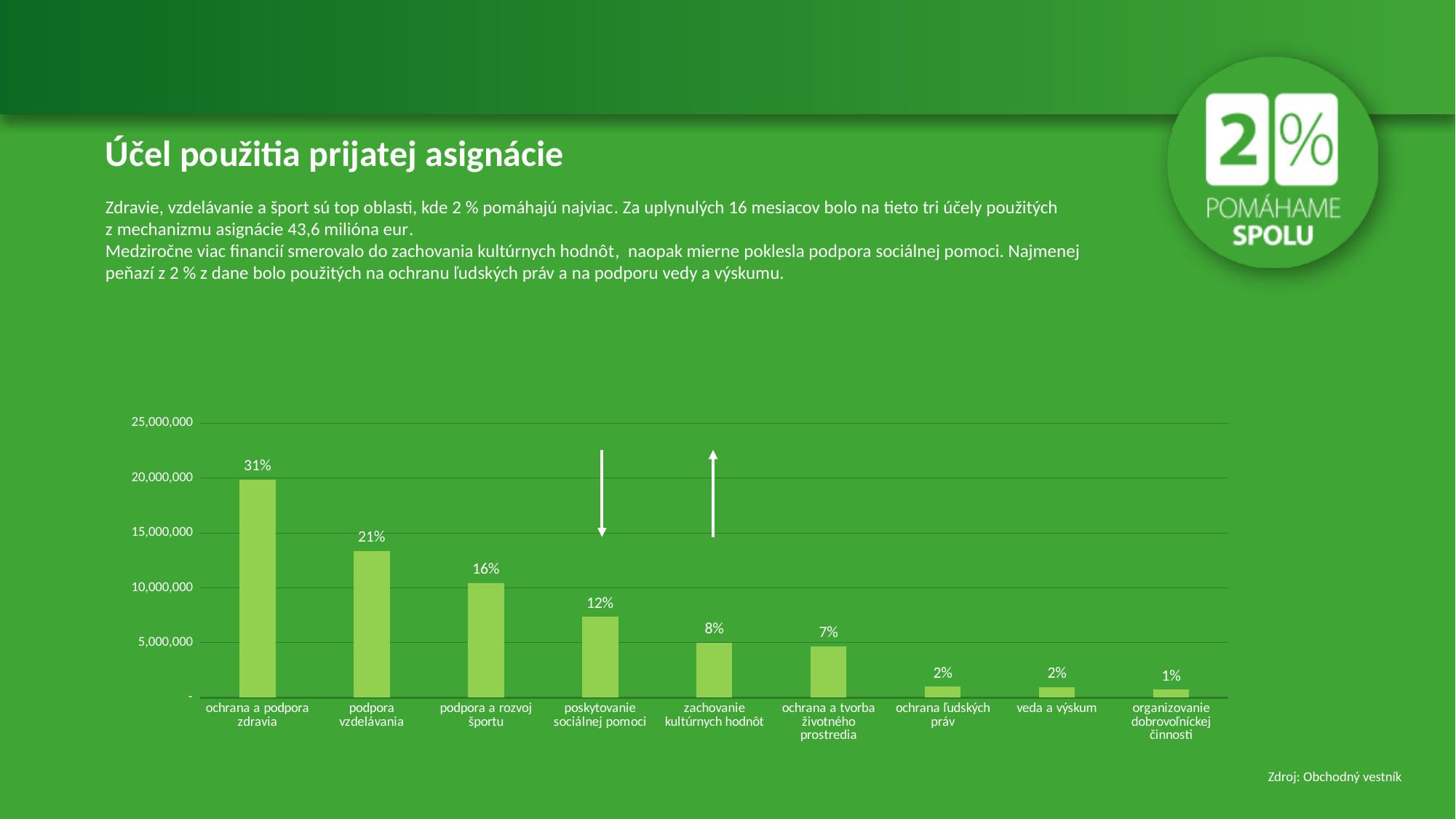
Which bar is taller: 'podpora a rozvoj športu' or 'ochrana a tvorba životného prostredia'? podpora a rozvoj športu Is the value for 'poskytovanie sociálnej pomoci' greater or less than 10,000,000? less What kind of chart is shown on the slide? bar chart Is the value for 'ochrana a podpora zdravia' greater or less than 15,000,000? greater What percentage label is shown above the bar for 'podpora vzdelávania'? 21% What percentage label is shown above the bar for 'organizovanie dobrovoľníckej činnosti'? 1% What is the title of the slide containing the chart? Účel použitia prijatej asignácie What percentage label is shown above the bar for 'ochrana a podpora zdravia'? 31% What percentage label is shown above the bar for 'zachovanie kultúrnych hodnôt'? 8% How many categories are shown on the x axis of the chart? 9 Which category has the highest bar in the chart? ochrana a podpora zdravia Which category has the lowest bar in the chart? organizovanie dobrovoľníckej činnosti